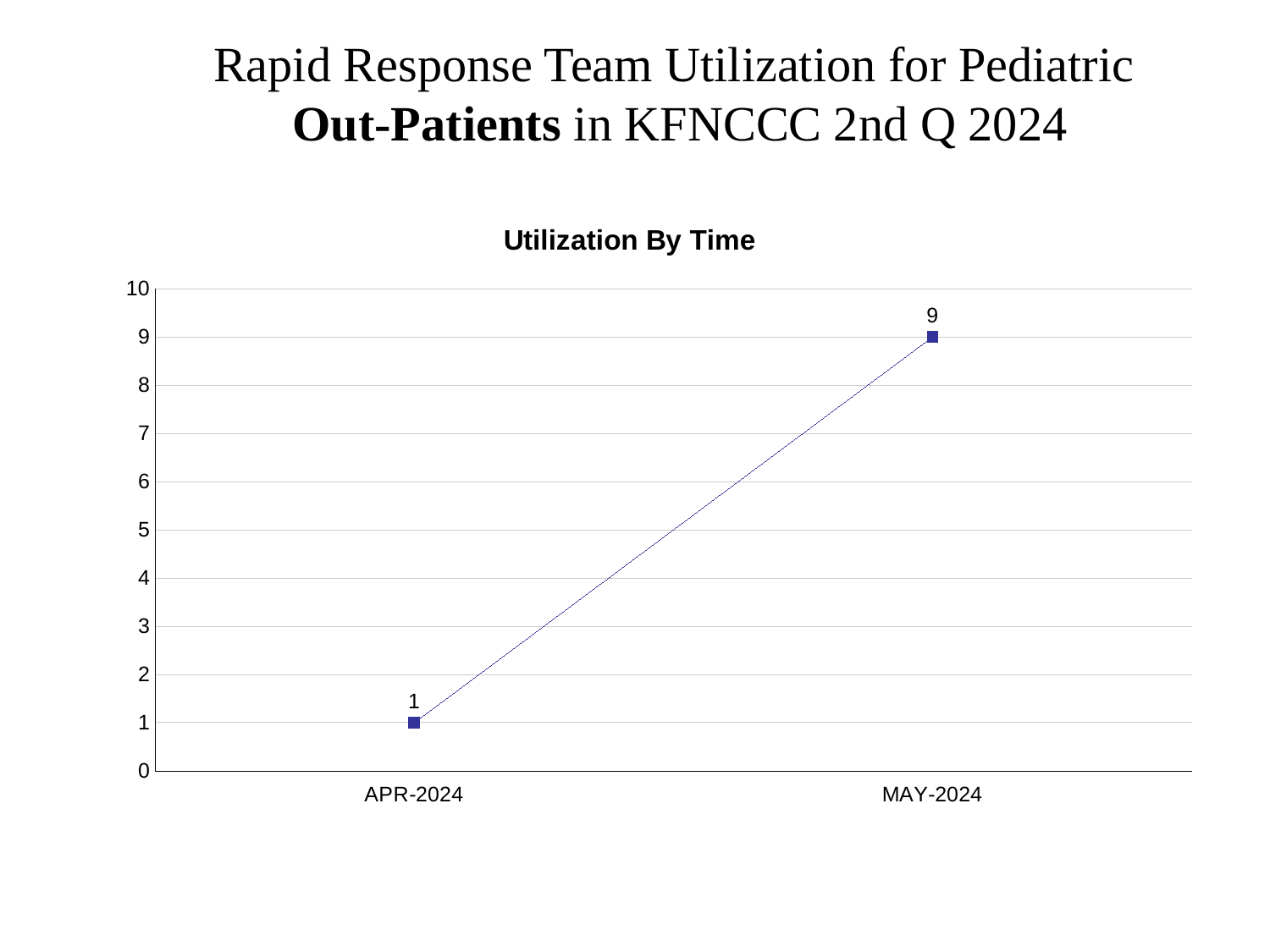
Which is larger, the value for APR-2024 or the value for MAY-2024? MAY-2024 What is the value for APR-2024? 1 What kind of chart is shown on the slide? line chart How many data points are plotted on the chart? 2 Do the values rise or fall from APR-2024 to MAY-2024? rise What is the maximum value shown on the vertical axis? 10 Is the value for MAY-2024 greater or less than 5? greater Which month has the lowest value? APR-2024 Which month has the highest value? MAY-2024 What is the value for MAY-2024? 9 What is the difference between the values for MAY-2024 and APR-2024? 8 What is the title of the chart? Utilization By Time